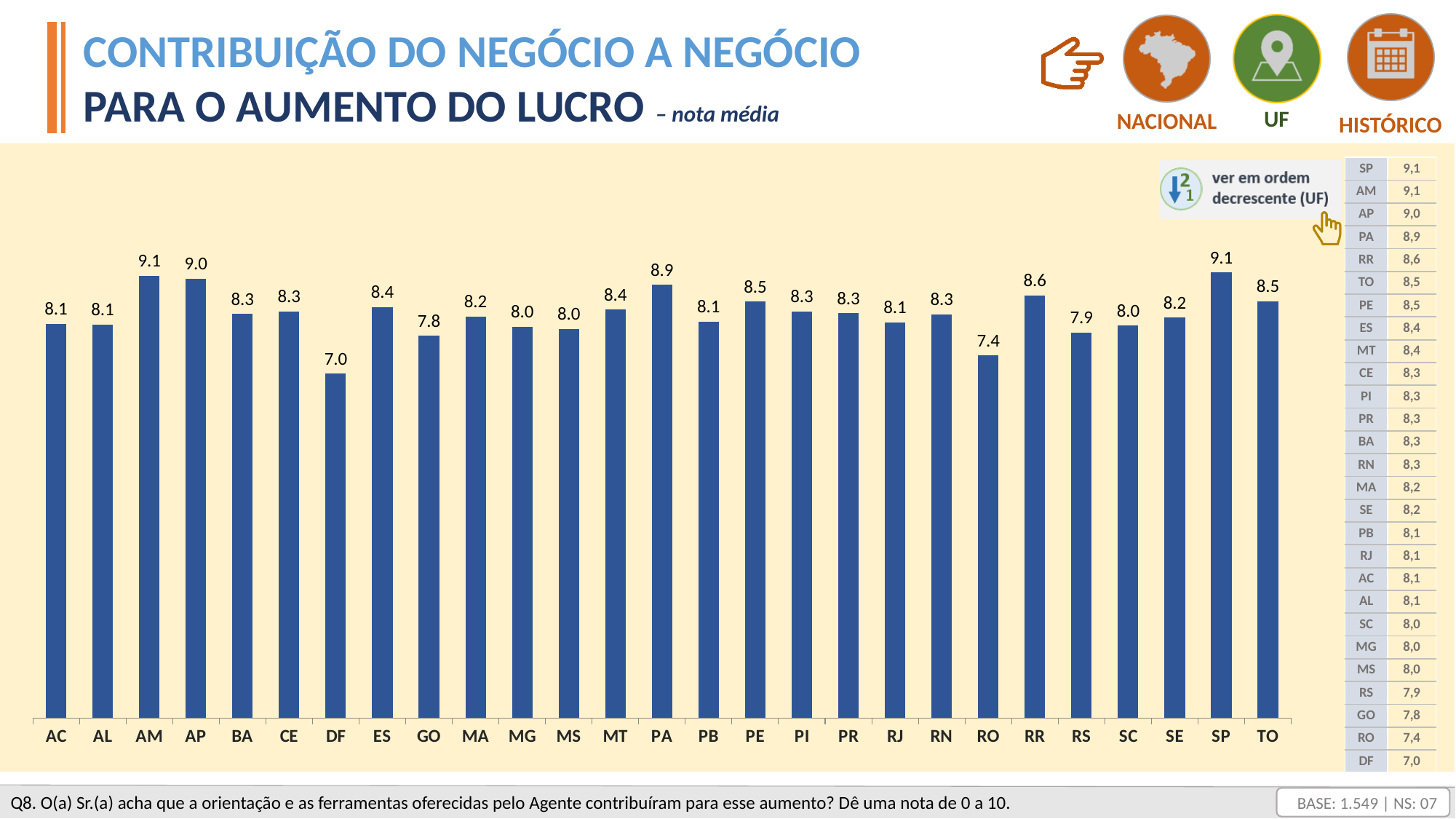
What is the value for DF? 7.0 How many categories (UFs) are shown on the x axis? 27 What is the value for TO? 8.5 What kind of chart is shown on the slide? Bar chart Which category has the lowest value? DF What is the difference between the values for AP and DF? 2.0 Which is larger, the value for RS or the value for ES? ES What is the difference between the values for SP and RO? 1.7 Which is larger, the value for PE or the value for GO? PE What is the value for PA? 8.9 What is the value for RO? 7.4 What is the value for RR? 8.6